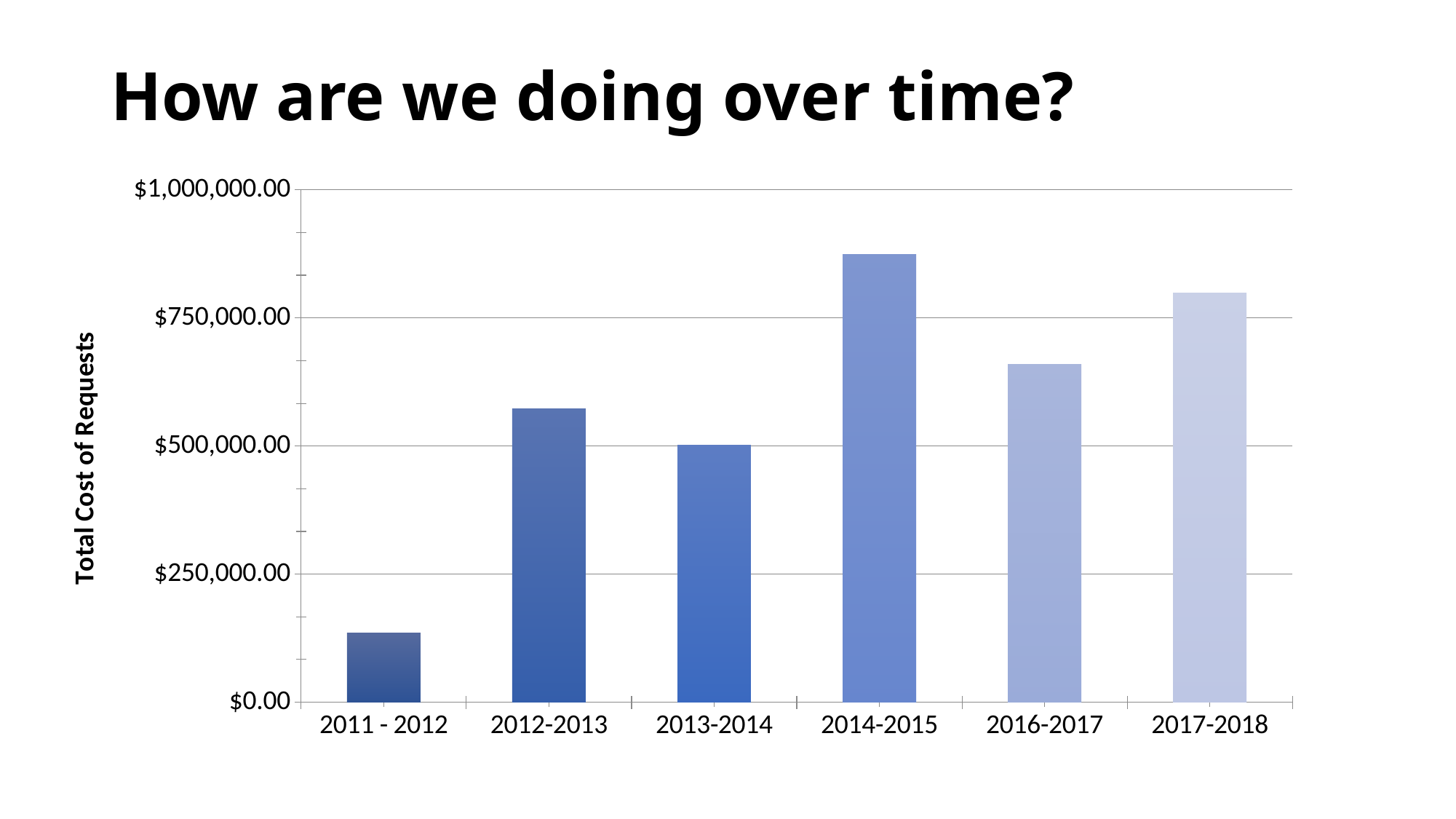
Which year period has the highest total cost of requests? 2014-2015 How many year categories are shown on the x axis? 6 Is the value for 2011 - 2012 greater or less than $250,000.00? less Is the value for 2014-2015 greater or less than $750,000.00? greater Which year period has the lowest total cost of requests? 2011 - 2012 Which is larger, the value for 2012-2013 or the value for 2013-2014? 2012-2013 What is the label on the vertical axis? Total Cost of Requests Is the value for 2016-2017 greater or less than $750,000.00? less What kind of chart is shown on the slide? bar chart Does the value rise or fall from 2011 - 2012 to 2012-2013? rise Which is larger, the value for 2016-2017 or the value for 2017-2018? 2017-2018